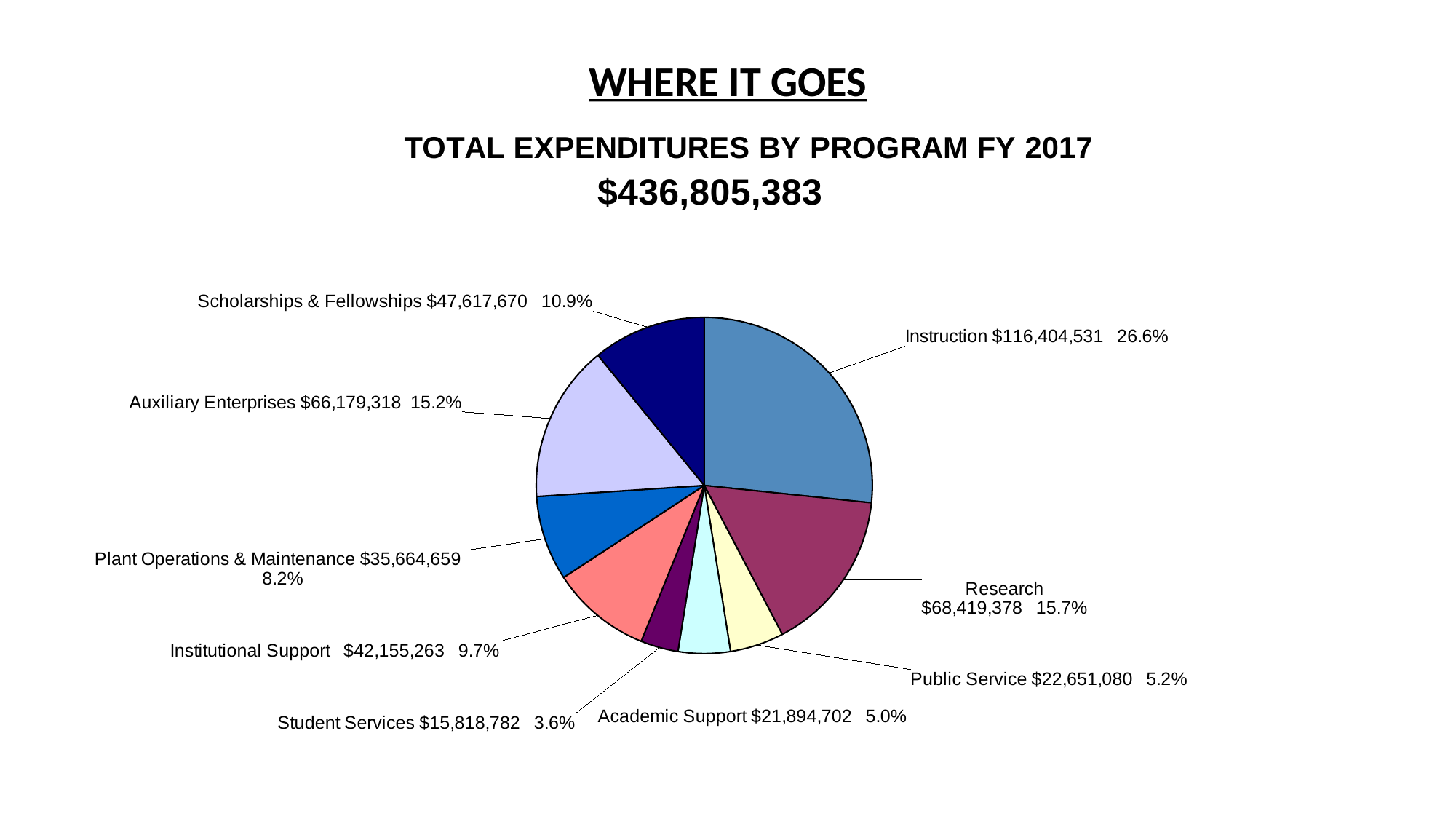
Which program has the largest share of expenditures? Instruction What is the expenditure amount for Auxiliary Enterprises? $66,179,318 What is the expenditure amount for Plant Operations & Maintenance? $35,664,659 Which program has the smallest share of expenditures? Student Services What percentage share does Research have? 15.7% What percentage share does Scholarships & Fellowships have? 10.9% What type of chart is shown on the slide? pie chart How many program categories are shown in the pie chart? 9 Which is larger, the expenditure for Public Service or Academic Support? Public Service What is the expenditure amount for Instruction? $116,404,531 What is the total expenditure figure shown on the slide? $436,805,383 What is the difference in percentage share between Instruction and Research? 10.9%